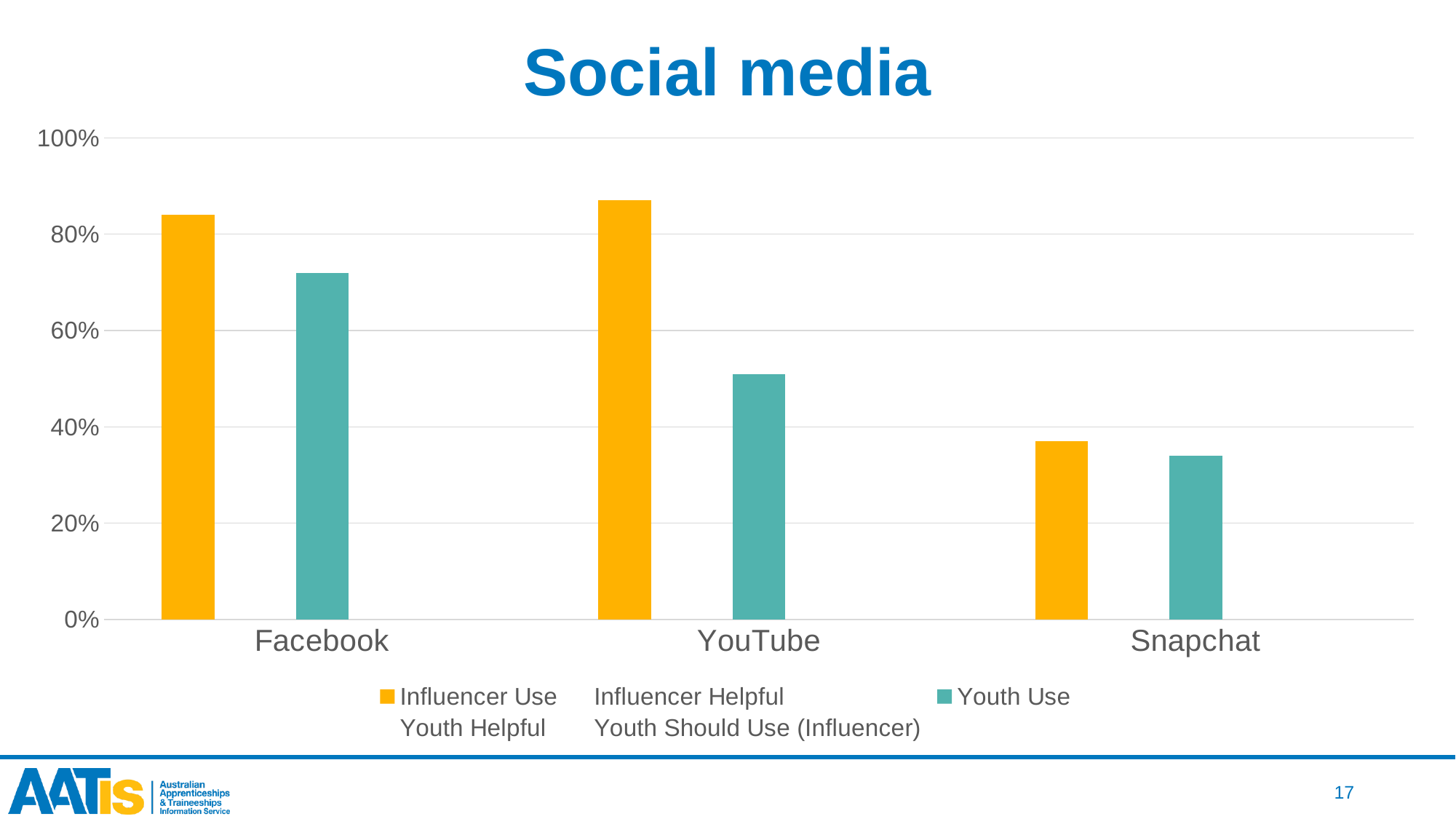
What kind of chart is shown on the slide? Bar chart For YouTube, which is larger: Influencer Use or Youth Use? Influencer Use Is the Influencer Use value for Facebook greater or less than 80%? greater Is the Youth Use value for YouTube greater or less than 60%? less Which platform has the lowest Youth Use value? Snapchat What is the title of the chart? Social media What colour are the Youth Use bars? Teal Is the Influencer Use value for Snapchat greater or less than 40%? less Which platform has the lowest Influencer Use value? Snapchat How many social media platforms are shown on the x axis? 3 Which platform has the highest Youth Use value? Facebook